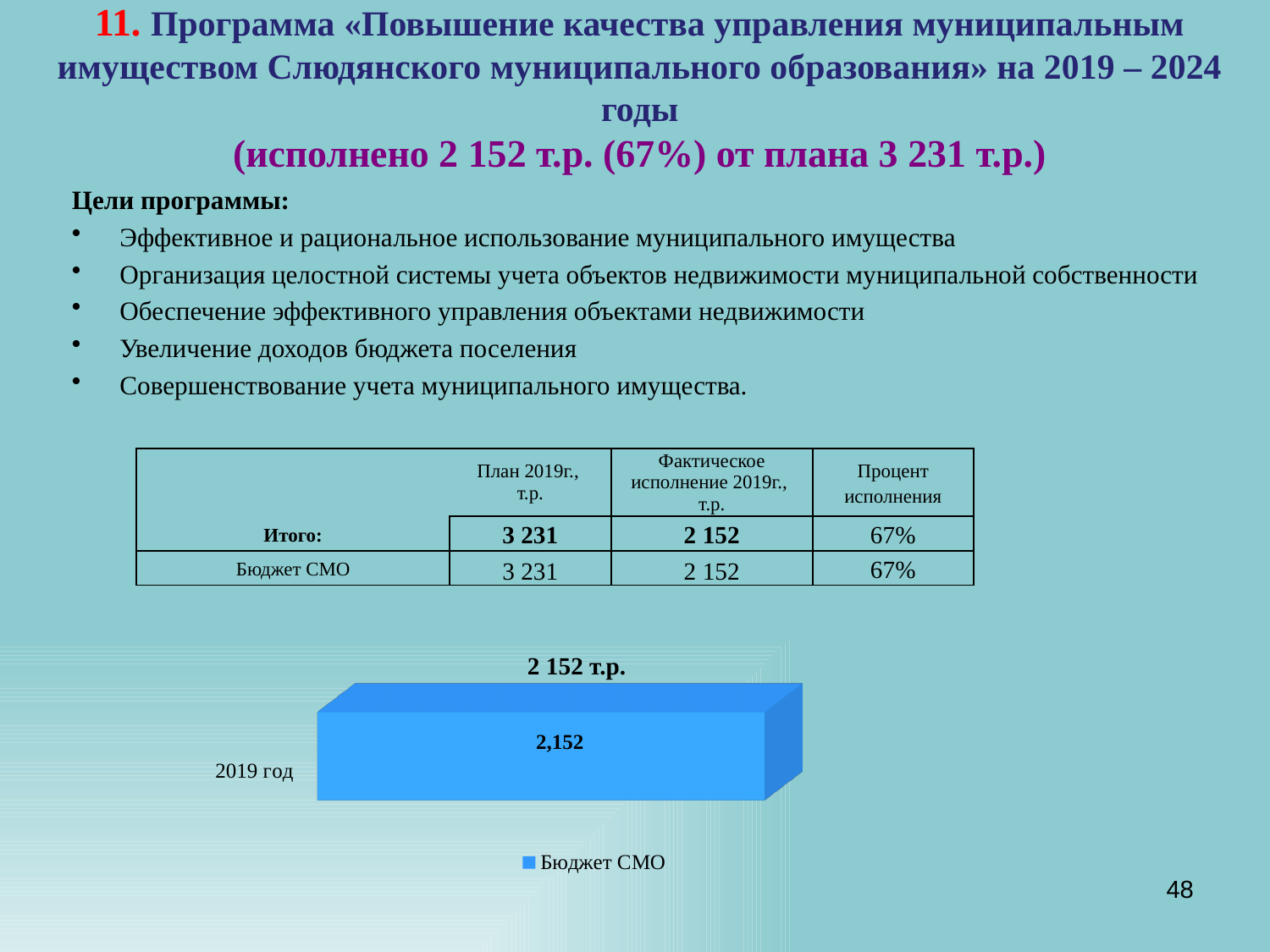
What kind of chart is shown on the slide? Bar chart Which year is labelled on the chart's category axis? 2019 год What is the value of the bar for 2019 год in the chart? 2,152 What value does the data label on the Бюджет СМО bar show? 2,152 How many categories appear on the chart's category axis? 1 How many series does the chart legend list? 1 How many bars are plotted in the chart? 1 What is the title of the chart? 2 152 т.р. What series name is shown in the chart legend? Бюджет СМО